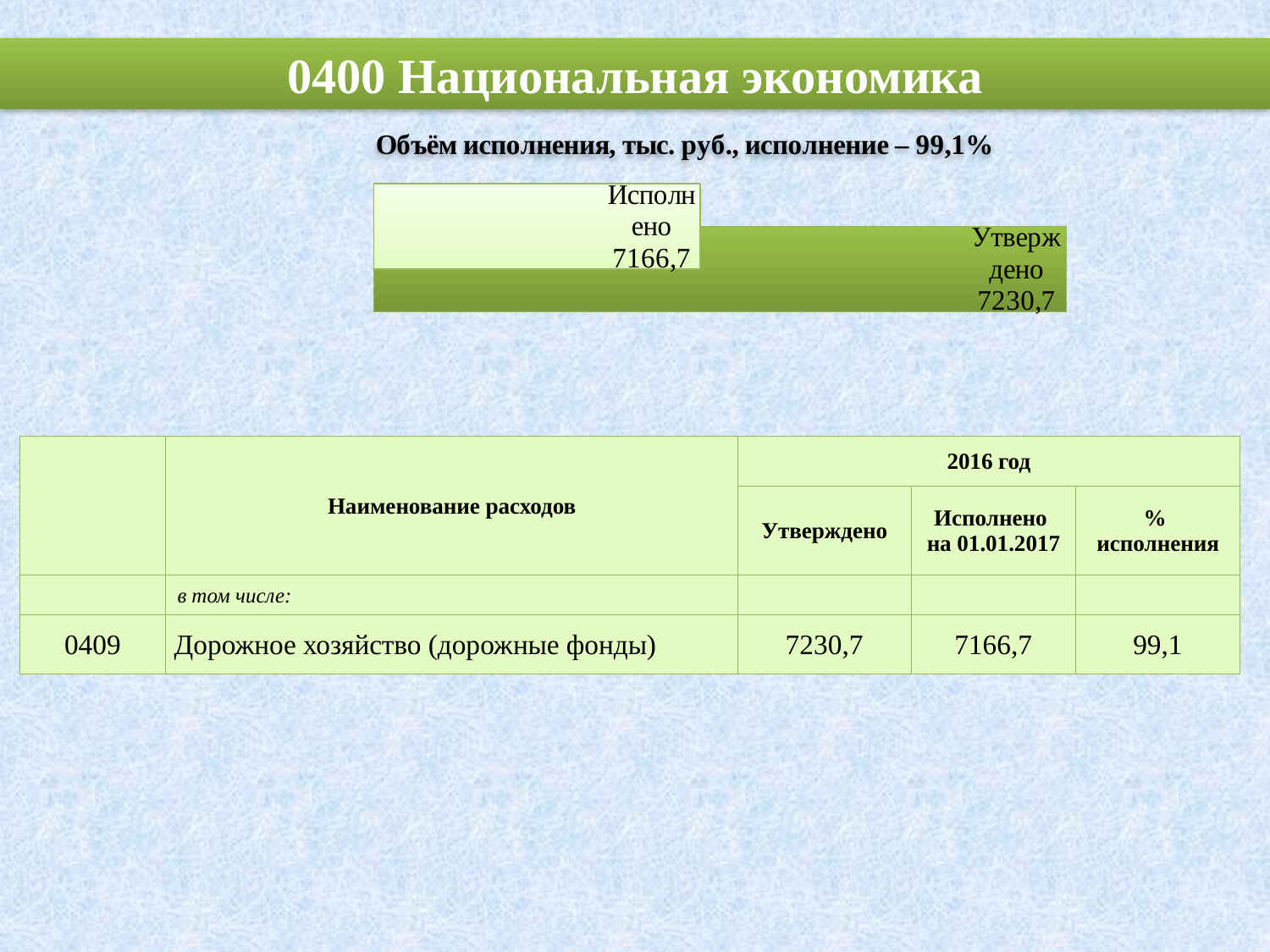
Which bar shows the largest value? Утверждено How many bars are plotted in the chart? 2 What is the difference between the Утверждено and Исполнено values? 64,0 What is the title of the chart? Объём исполнения, тыс. руб., исполнение – 99,1% What is the value of the bar labelled Утверждено? 7230,7 What is the value of the bar labelled Исполнено? 7166,7 Which bar has the higher value, Исполнено or Утверждено? Утверждено What kind of chart is shown on the slide? bar chart Which bar shows the smallest value? Исполнено What execution percentage is stated in the chart title? 99,1%